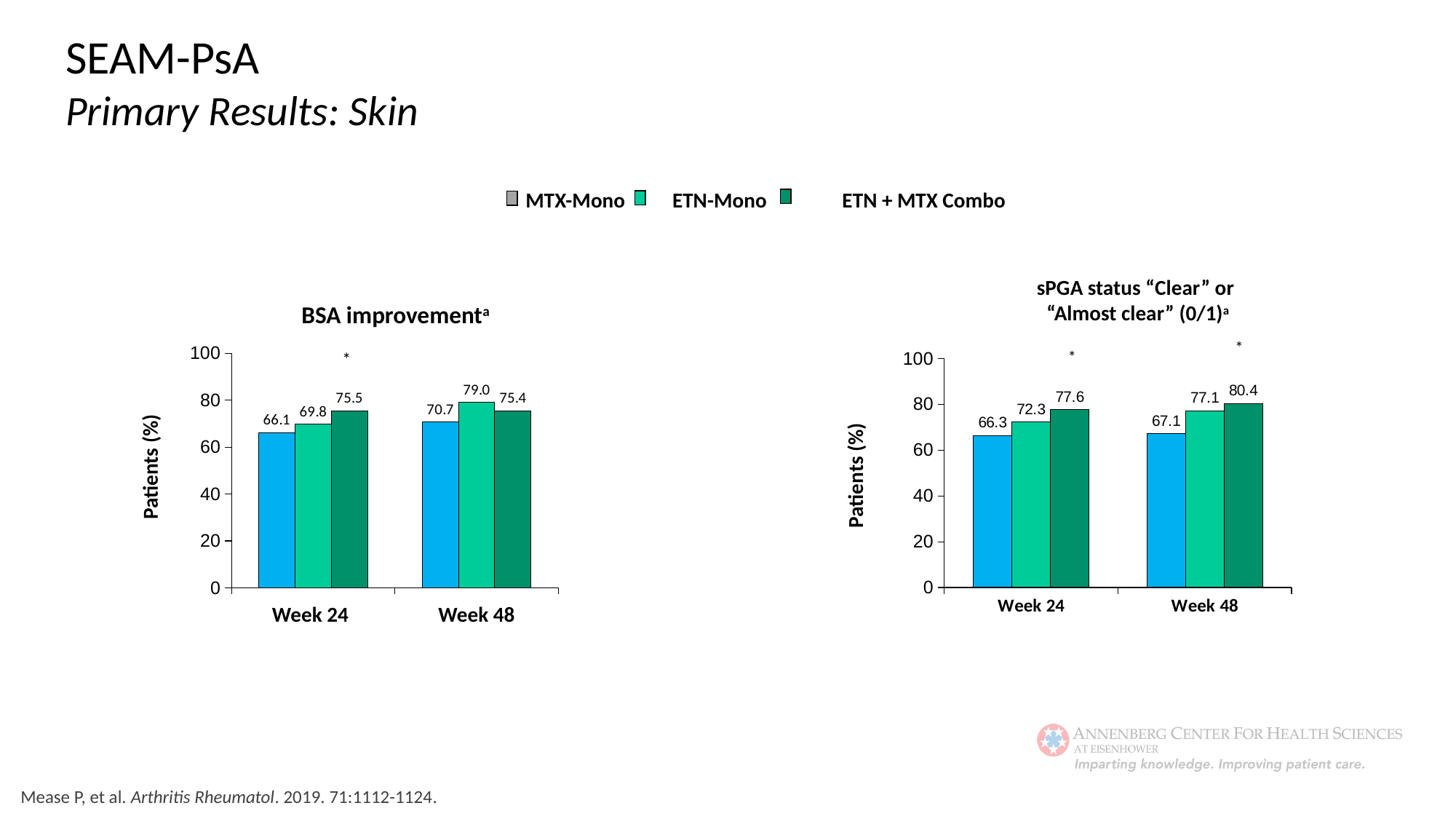
How many series does the legend list? 3 What type of chart is the BSA improvement chart? bar chart In the sPGA status chart, what is the value for ETN + MTX Combo at Week 48? 80.4 In the sPGA status chart, which series has the lowest value at Week 24? MTX-Mono In the sPGA status chart, what is the difference between ETN + MTX Combo and MTX-Mono at Week 48? 13.3 In the BSA improvement chart, which is larger at Week 24: ETN-Mono or ETN + MTX Combo? ETN + MTX Combo In the sPGA status chart, what is the value for MTX-Mono at Week 48? 67.1 In the BSA improvement chart, which series has the highest value at Week 48? ETN-Mono In the BSA improvement chart, what is the value for ETN + MTX Combo at Week 24? 75.5 In the BSA improvement chart, what is the value for ETN-Mono at Week 48? 79.0 In the BSA improvement chart, what is the difference between ETN-Mono and MTX-Mono at Week 24? 3.7 In the sPGA status chart, does the MTX-Mono value rise or fall from Week 24 to Week 48? rise